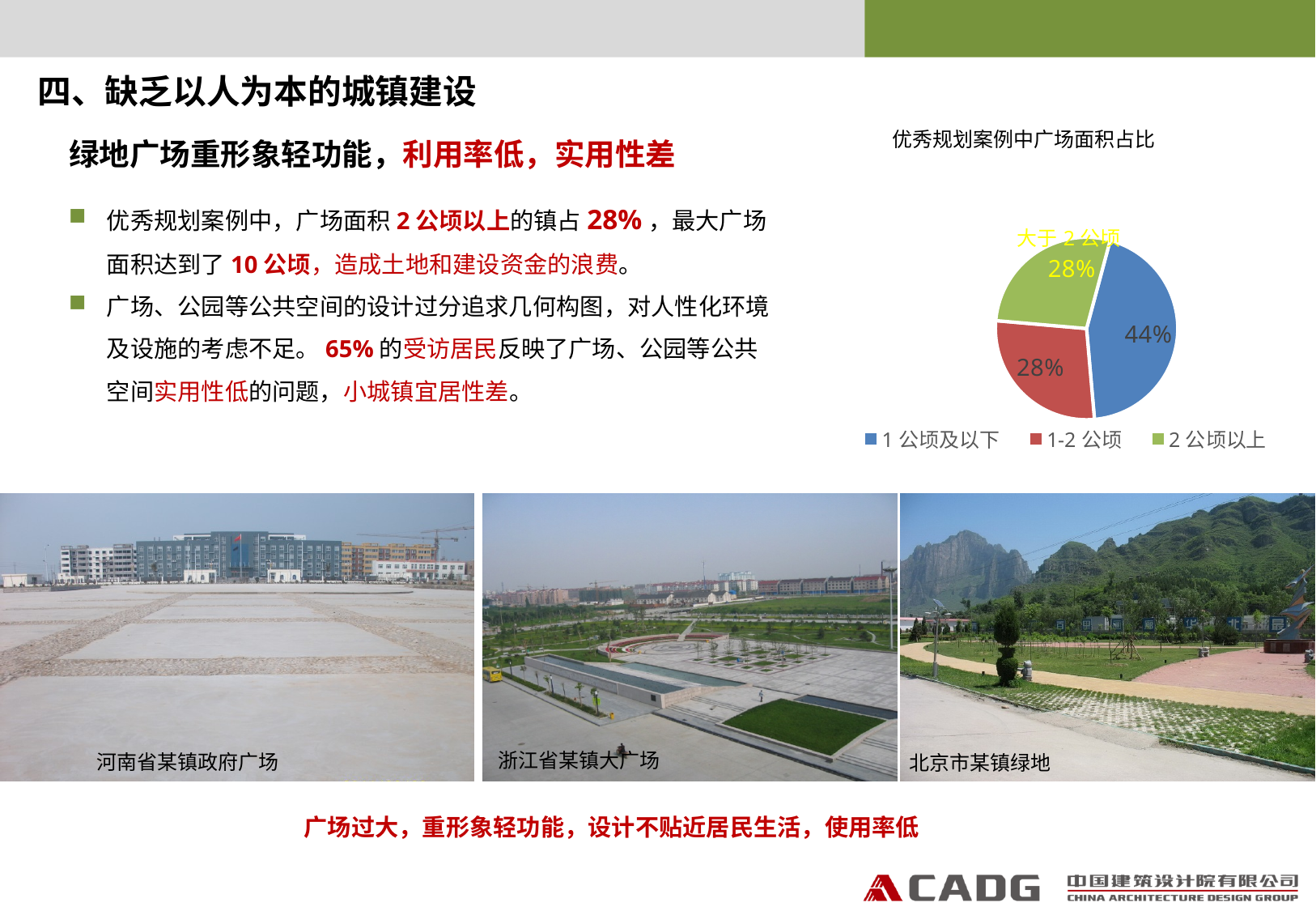
How many slices does the pie chart have? 3 What colour is the 2 公顷以上 slice in the pie chart? green How many entries does the chart legend list? 3 What share of the pie does the 1-2 公顷 slice represent? 28% What type of chart is shown on the slide? pie chart Which is larger, the share for 1 公顷及以下 or the share for 2 公顷以上? 1 公顷及以下 What is the difference between the share for 1 公顷及以下 and the share for 1-2 公顷? 16% Which category has the largest slice of the pie? 1 公顷及以下 What is the combined share of the 1-2 公顷 and 2 公顷以上 slices? 56% What is the title of the chart on the slide? 优秀规划案例中广场面积占比 What share of the pie does the 2 公顷以上 slice represent? 28% What share of the pie does the 1 公顷及以下 slice represent? 44%